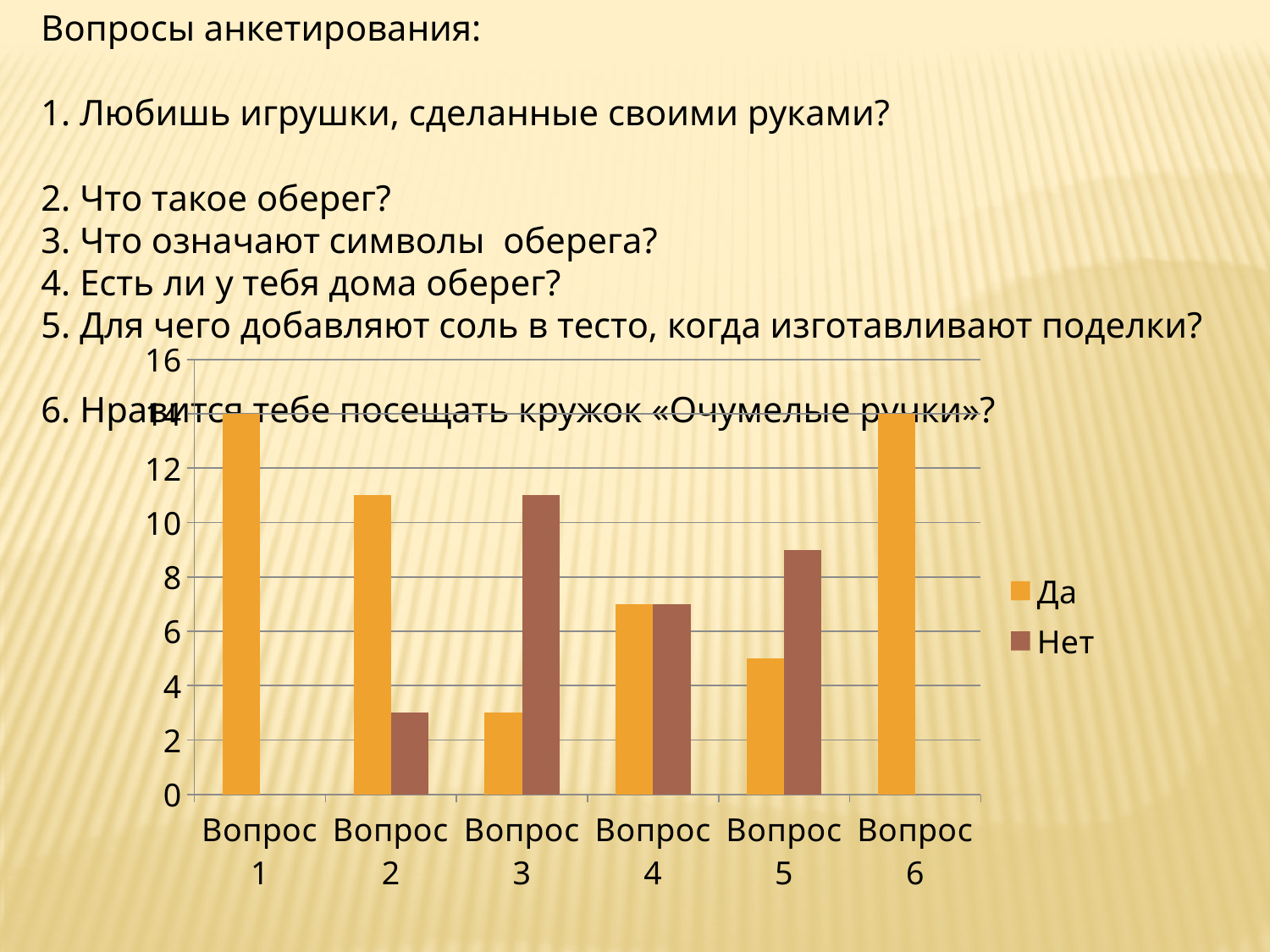
Is the value of Да for Вопрос 5 greater or less than 6? less What kind of chart is shown on the slide? bar chart Which question has the highest value for Нет? Вопрос 3 How many series does the chart legend list? 2 For Вопрос 5, which is larger: Да or Нет? Нет Which question has the lowest value for Да? Вопрос 3 For Вопрос 2, which is larger: Да or Нет? Да Is the value of Да for Вопрос 2 greater or less than 10? greater Is the value of Нет for Вопрос 3 greater or less than 10? greater What is the value of Да for Вопрос 1? 14 What are the two entries in the chart legend? Да, Нет How many categories (questions) are shown on the x axis of the chart? 6